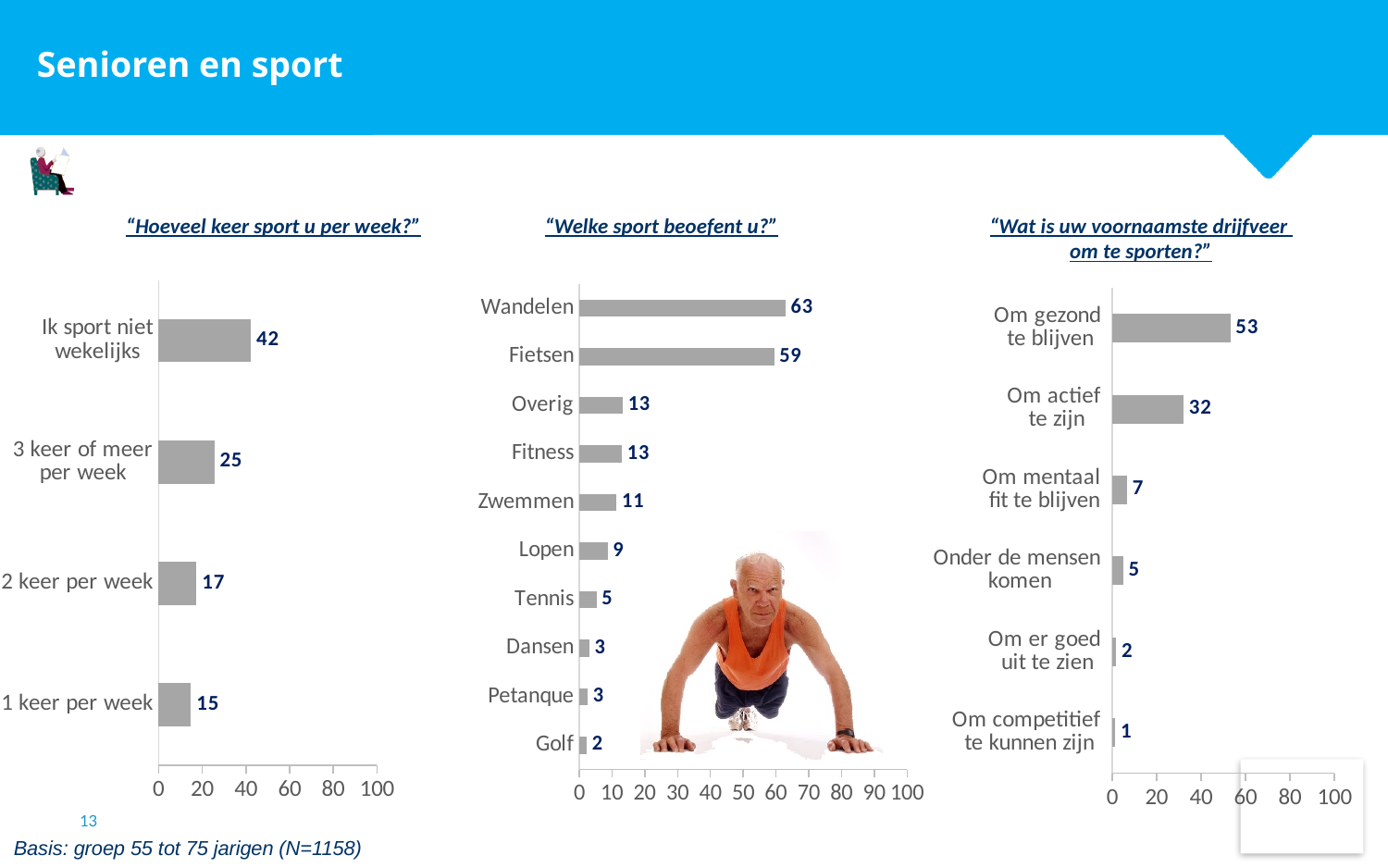
In the chart "Wat is uw voornaamste drijfveer om te sporten?", which category has the lowest value? Om competitief te kunnen zijn In the chart "Welke sport beoefent u?", what is the value for Fietsen? 59 In the chart "Welke sport beoefent u?", which sport has the highest value? Wandelen In the chart "Hoeveel keer sport u per week?", which category has the lowest value? 1 keer per week In the chart "Welke sport beoefent u?", how many sports are listed? 10 In the chart "Wat is uw voornaamste drijfveer om te sporten?", what is the value for "Om actief te zijn"? 32 In the chart "Wat is uw voornaamste drijfveer om te sporten?", how many categories are shown? 6 In the chart "Welke sport beoefent u?", which is larger, Zwemmen or Lopen? Zwemmen In the chart "Welke sport beoefent u?", what is the difference between Wandelen and Fietsen? 4 In the chart "Hoeveel keer sport u per week?", what is the difference between "3 keer of meer per week" and "2 keer per week"? 8 What type of chart is "Wat is uw voornaamste drijfveer om te sporten?"? Bar chart In the chart "Hoeveel keer sport u per week?", what is the value for "Ik sport niet wekelijks"? 42